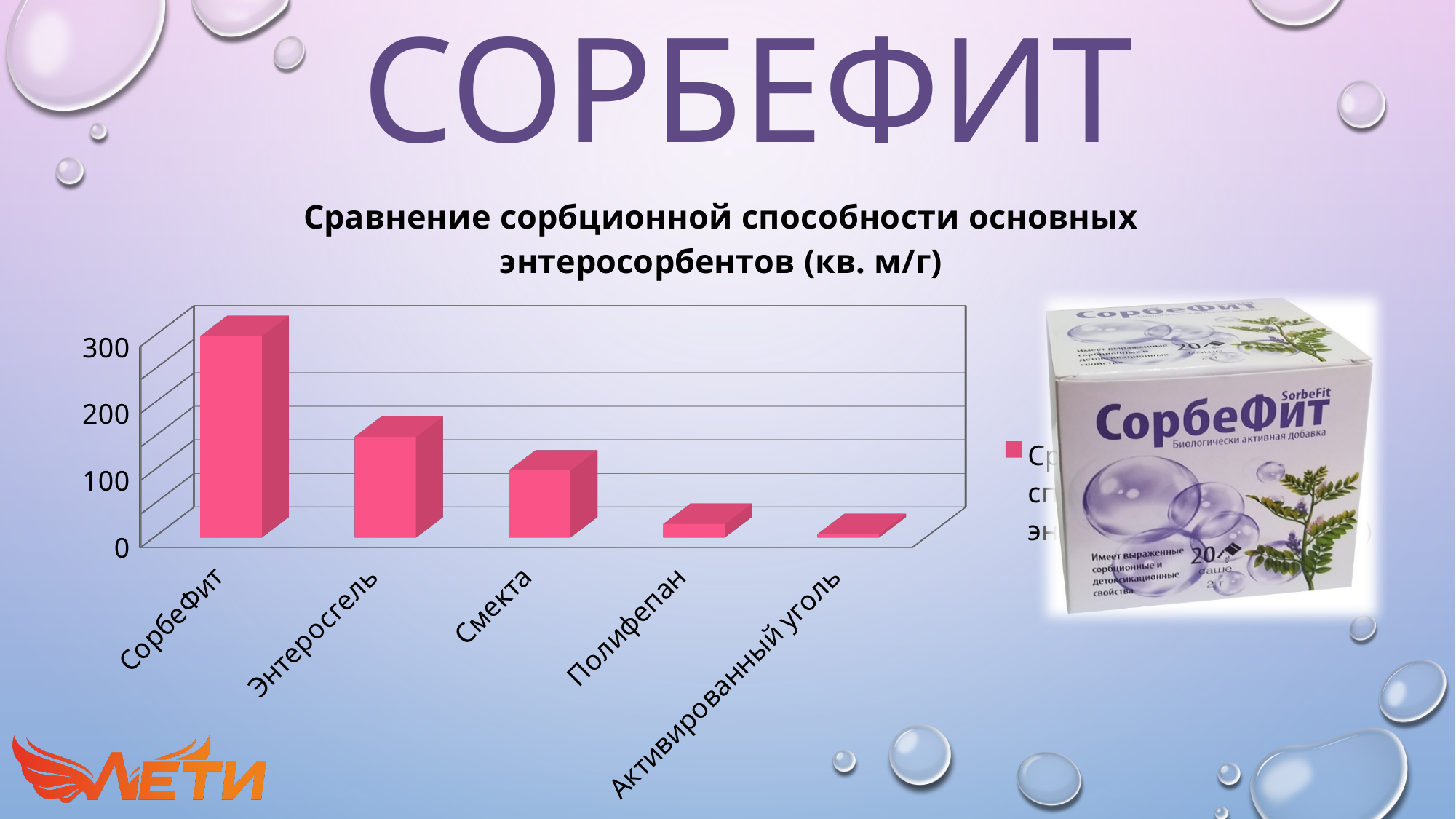
Which category has the lowest value in the chart? Активированный уголь Which has a larger value, Энтеросгель or Смекта? Энтеросгель What kind of chart is shown on the slide? bar chart Is the value for Сорбефит greater or less than 200? greater Is the value for Энтеросгель greater or less than 100? greater How many categories are shown on the x axis of the chart? 5 Is the value for Энтеросгель greater or less than 200? less Do the values rise or fall moving left to right along the x axis? fall What is the title of the chart? Сравнение сорбционной способности основных энтеросорбентов (кв. м/г) Which category has the highest value in the chart? Сорбефит